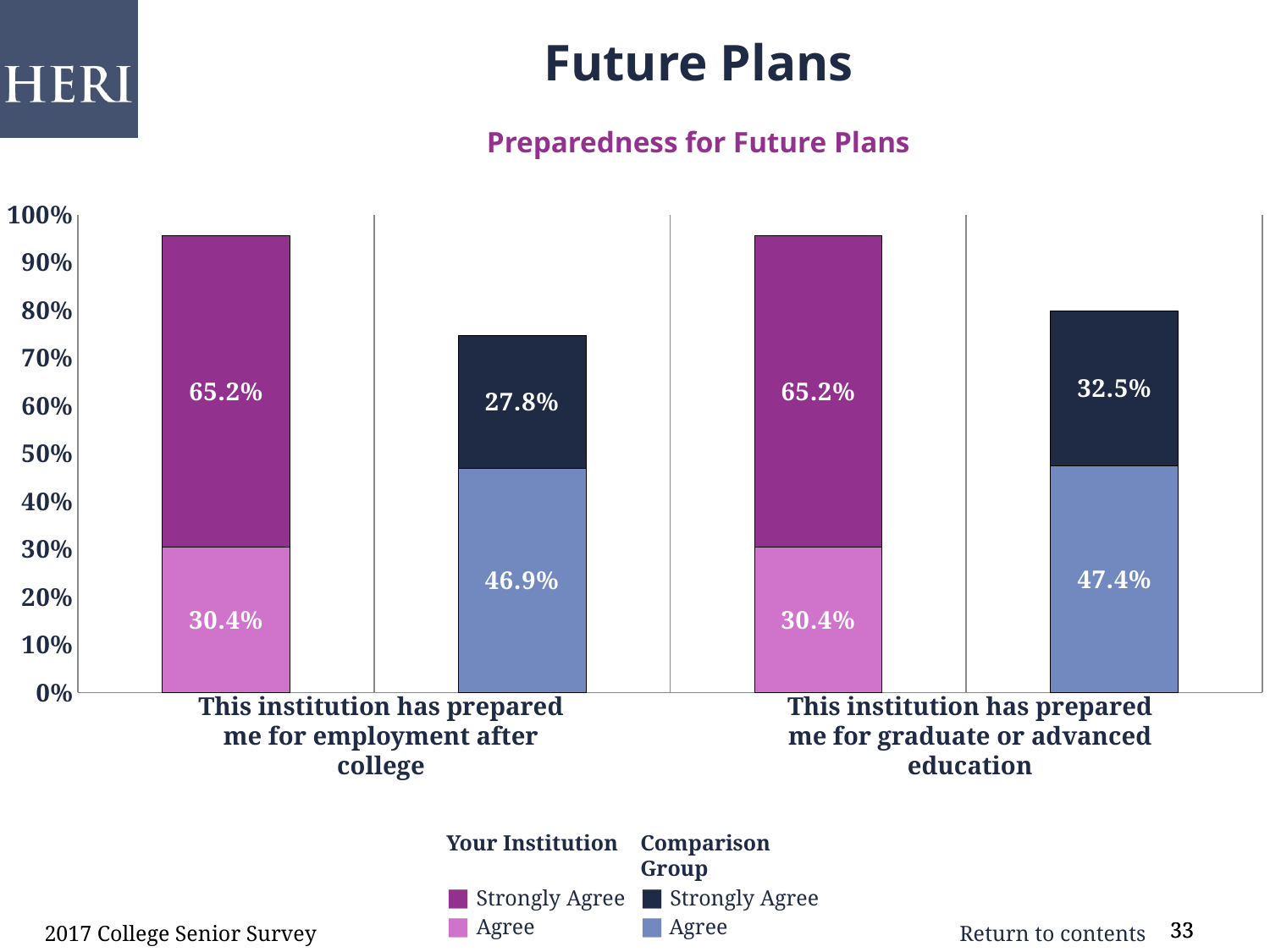
Which group has the higher Strongly Agree value for 'This institution has prepared me for employment after college', Your Institution or the Comparison Group? Your Institution What is the total of the Your Institution stacked bar for 'This institution has prepared me for employment after college'? 95.6% What kind of chart is shown on the slide? Stacked bar chart What is the Your Institution Agree value for 'This institution has prepared me for graduate or advanced education'? 30.4% What percentage of the Comparison Group agree (not strongly) that the institution has prepared them for graduate or advanced education? 47.4% Which is larger for 'This institution has prepared me for graduate or advanced education': the Comparison Group's Strongly Agree value or its Agree value? Agree What is the title of the chart? Preparedness for Future Plans What percentage of Your Institution respondents strongly agree that the institution has prepared them for employment after college? 65.2% How many entries does the chart legend list? 4 What is the difference between the Your Institution and Comparison Group Strongly Agree values for 'This institution has prepared me for employment after college'? 37.4% What is the total of the Comparison Group stacked bar for 'This institution has prepared me for graduate or advanced education'? 79.9% What is the Comparison Group's Strongly Agree value for 'This institution has prepared me for employment after college'? 27.8%